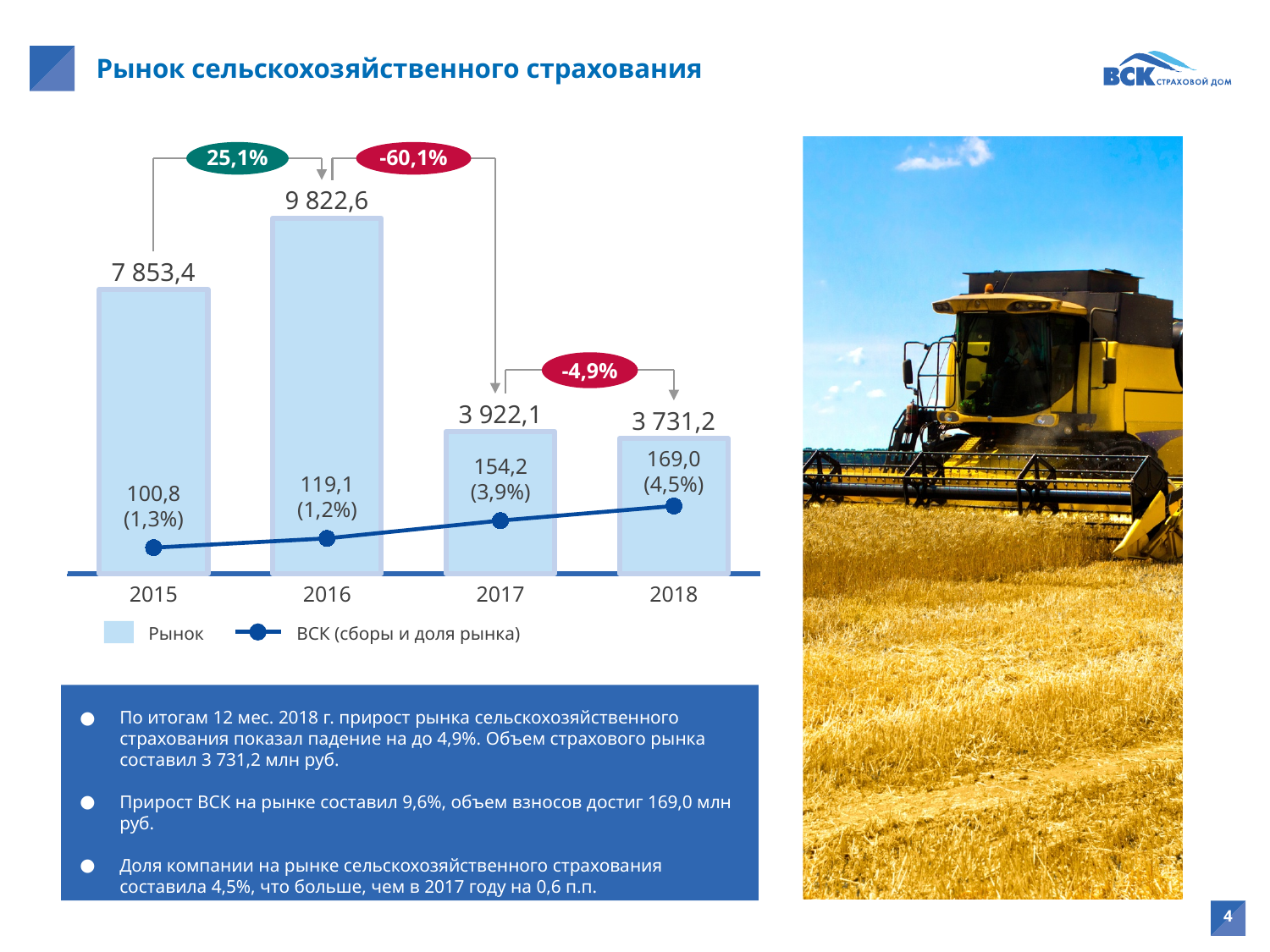
What percentage change is shown between the 2016 and 2017 Рынок values? -60,1% What are the ВСК collections and market share shown for 2017? 154,2 (3,9%) What is the value of the Рынок bar for 2016? 9 822,6 What is the difference between the Рынок values for 2016 and 2015? 1 969,2 How many series does the legend list? 2 How many years are shown on the x axis? 4 Which is larger, the Рынок value for 2017 or for 2018? 2017 What kind of chart is this? Combined bar and line chart What is the value of the Рынок bar for 2018? 3 731,2 Which year has the highest Рынок value? 2016 What market share is shown for ВСК in 2015? 1,3% Which year has the lowest Рынок value? 2018